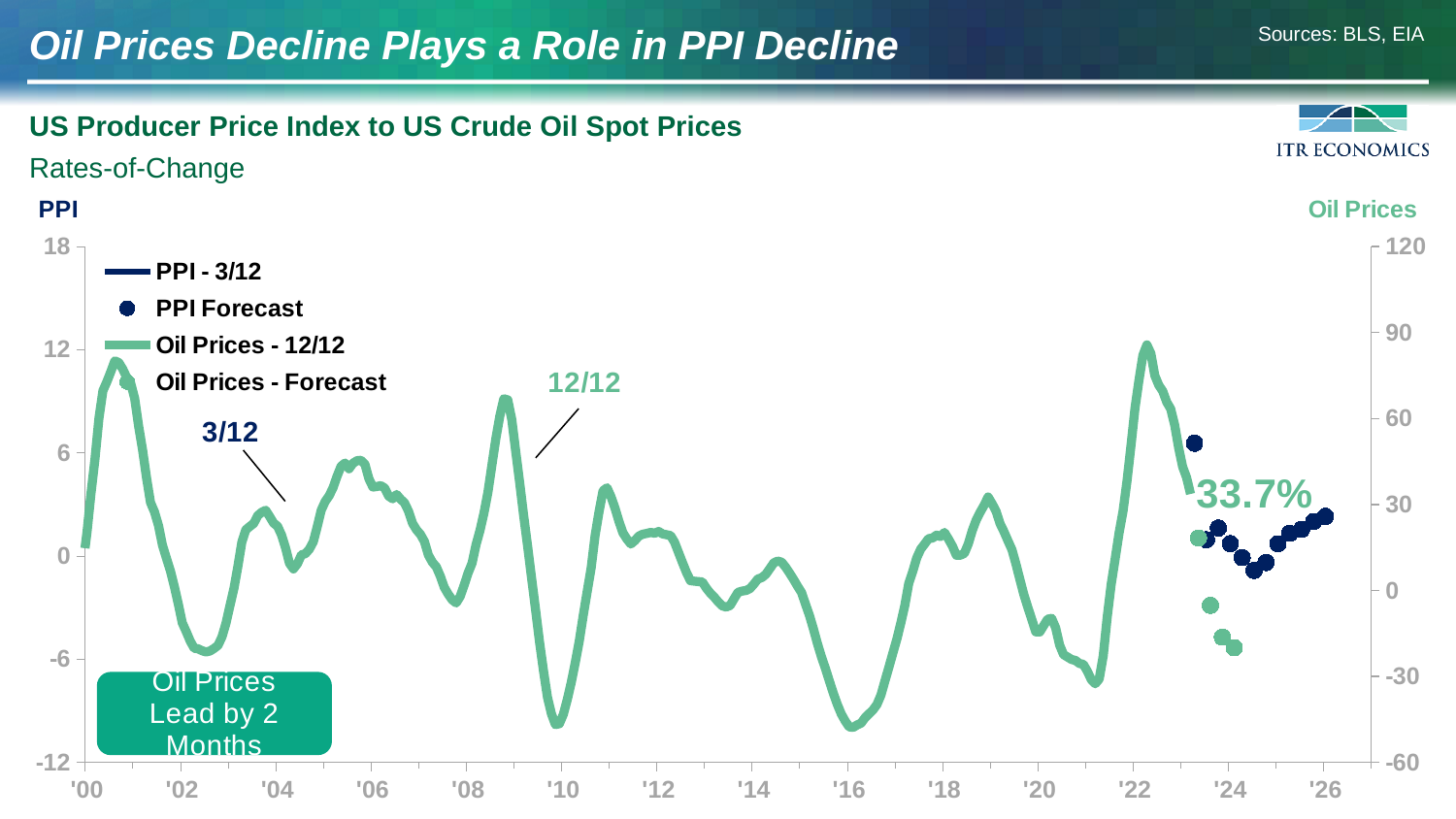
How many year labels are shown on the x axis? 14 Is the trough of the Oil Prices - 12/12 line around '10 greater or less than -30 on the right axis? less What is the title of the chart? US Producer Price Index to US Crude Oil Spot Prices Are the PPI Forecast dots around '26 greater or less than 0 on the left axis? greater According to the text box on the chart, by how many months do Oil Prices lead? 2 Months What value is printed as a data label near the end of the Oil Prices line? 33.7% What kind of chart is shown on the slide? line chart Do the PPI Forecast dots rise or fall from '24 to '26? rise How many series does the legend list? 4 Are the Oil Prices - Forecast dots around '24 greater or less than 0 on the right axis? less Does the Oil Prices - 12/12 line rise or fall from '22 to '23? fall